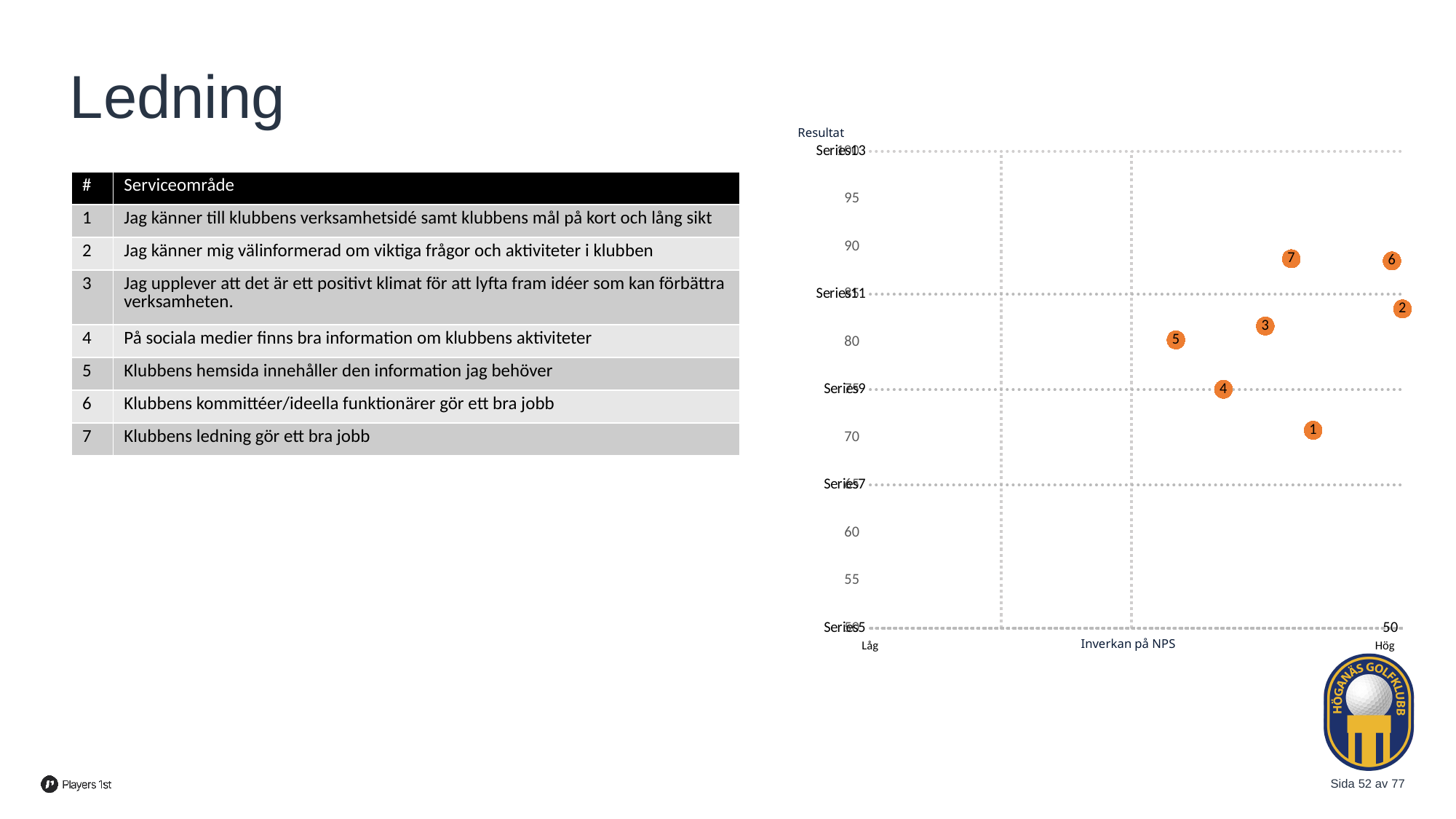
What is the title of the vertical axis of the chart? Resultat Which has a higher Resultat value, point 2 or point 4? 2 Is the Resultat value for point 4 greater or less than 70? greater Which numbered point has the lowest Resultat value on the chart? 1 How many numbered data points are plotted on the chart? 7 What is the title of the horizontal axis of the chart? Inverkan på NPS Is the Resultat value for point 6 greater or less than 85? greater Is the Resultat value for point 1 greater or less than 75? less Which has a higher Resultat value, point 7 or point 1? 7 What kind of chart is shown on the slide? scatter chart